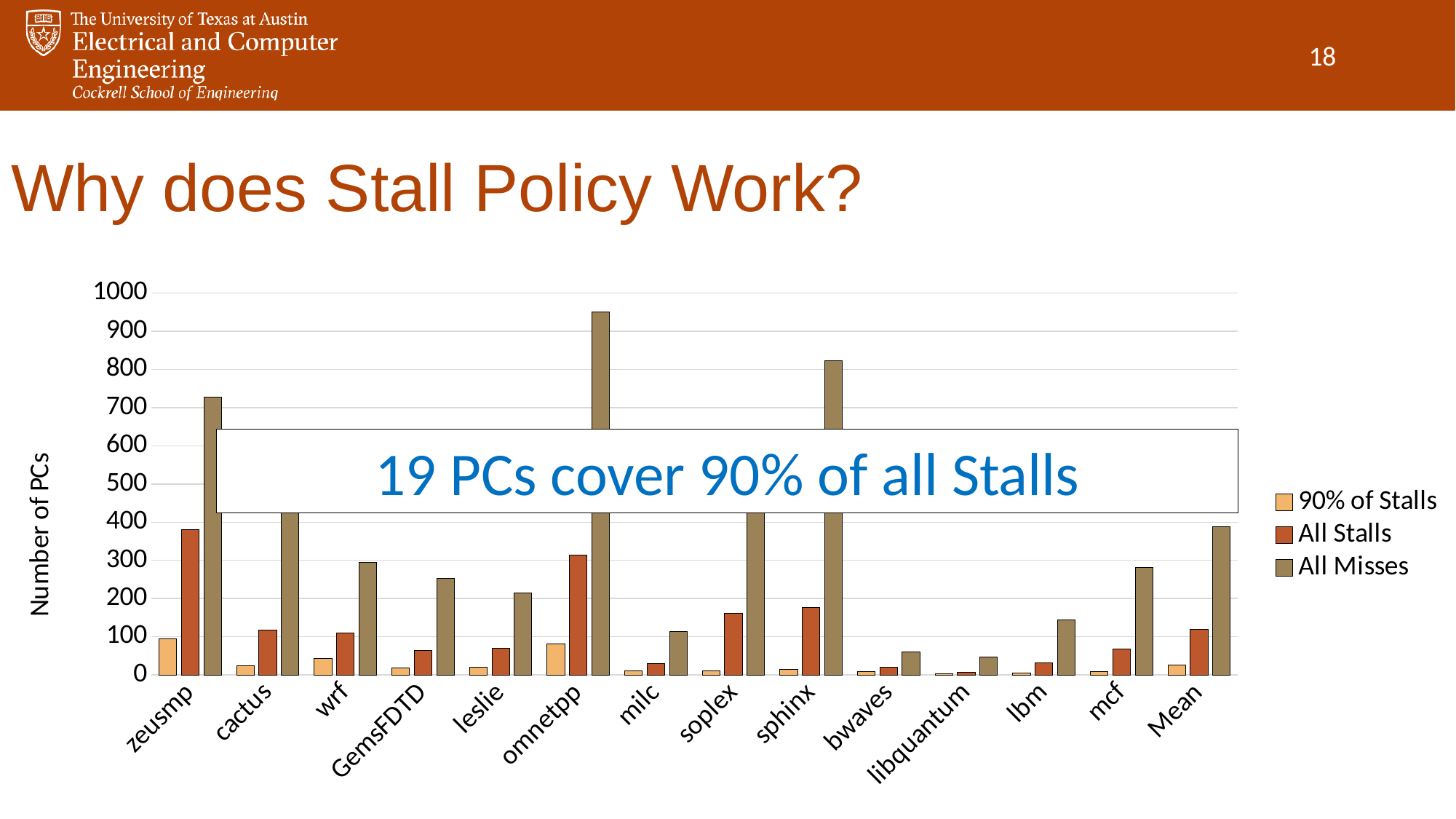
How many series does the legend list? 3 Which is larger, the All Stalls value for zeusmp or the All Stalls value for cactus? zeusmp Is the All Misses value for sphinx greater or less than 800? greater What kind of chart is shown on the slide? bar chart Is the All Misses value for omnetpp greater or less than 900? greater How many benchmark categories are shown on the x axis, including Mean? 14 Which category has the lowest All Misses value? libquantum Is the All Stalls value for zeusmp greater or less than 400? less What is the label on the y axis of the chart? Number of PCs Which category has the highest All Misses value? omnetpp Which category has the highest All Stalls value? zeusmp